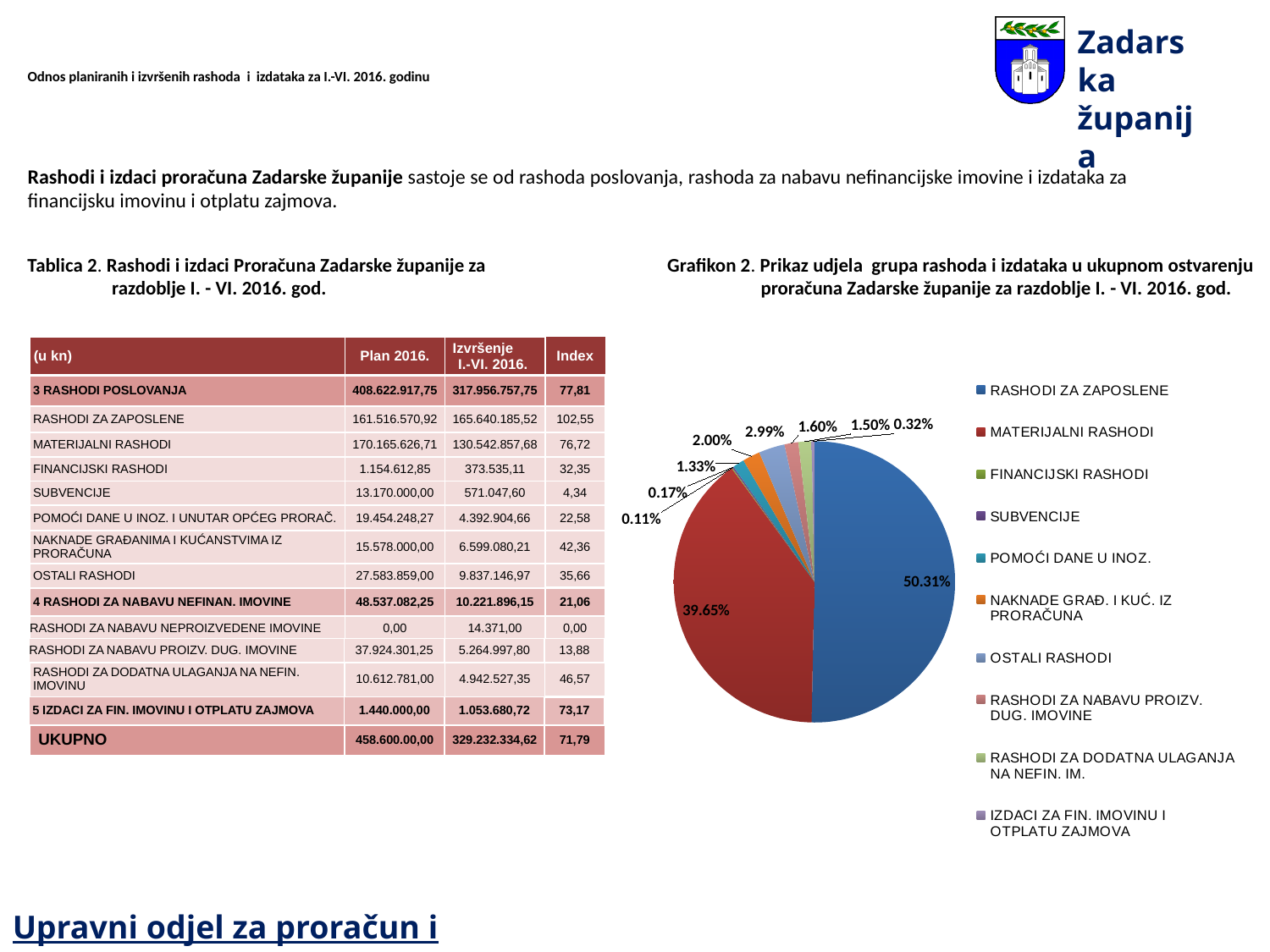
What is the difference in percentage points between the RASHODI ZA ZAPOSLENE slice and the MATERIJALNI RASHODI slice? 10.66 In the pie chart, what share does IZDACI ZA FIN. IMOVINU I OTPLATU ZAJMOVA have? 0.32% In the pie chart, what share does OSTALI RASHODI have? 2.99% In the pie chart, what share does MATERIJALNI RASHODI have? 39.65% What kind of chart is Grafikon 2? pie chart How many categories does the legend of the pie chart list? 10 In the pie chart, what share does RASHODI ZA ZAPOSLENE have? 50.31% Which category has the smallest slice in the pie chart? FINANCIJSKI RASHODI What is the combined share of the two largest slices in the pie chart? 89.96% Which category has the largest slice in the pie chart? RASHODI ZA ZAPOSLENE What colour is the RASHODI ZA ZAPOSLENE slice in the pie chart? blue Which slice is larger in the pie chart: NAKNADE GRAĐ. I KUĆ. IZ PRORAČUNA or POMOĆI DANE U INOZ.? NAKNADE GRAĐ. I KUĆ. IZ PRORAČUNA